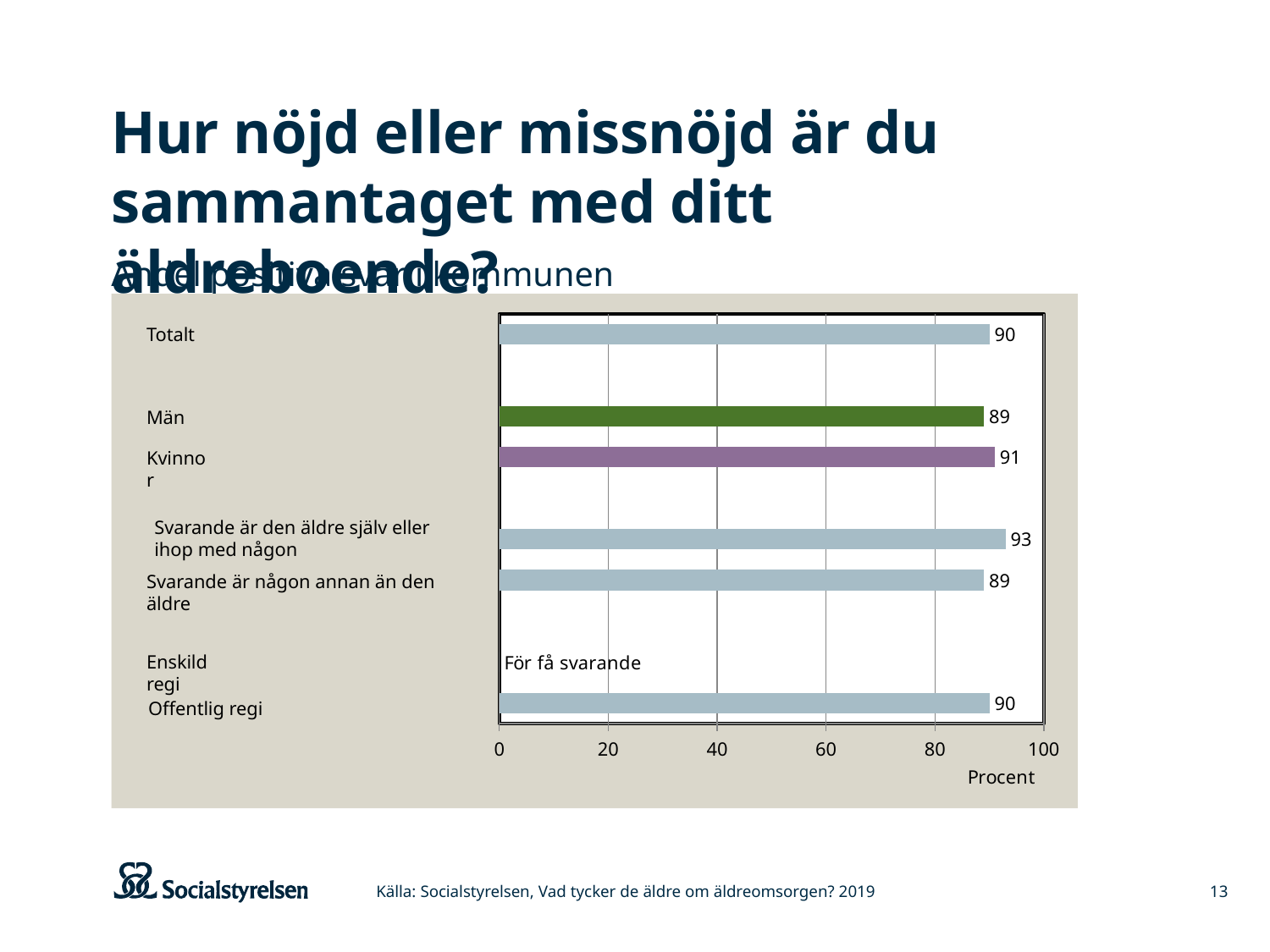
What is shown instead of a bar for Enskild regi? För få svarande Which is larger, the value for Kvinnor or the value for Män? Kvinnor Which category has the highest value? Svarande är den äldre själv eller ihop med någon What is the value for Totalt? 90 What is the value for Kvinnor? 91 What is the label of the x axis? Procent What is the value for 'Svarande är den äldre själv eller ihop med någon'? 93 What kind of chart is shown on the slide? Bar chart What is the difference between the values for Kvinnor and Män? 2 What is the value for Offentlig regi? 90 What is the value for Män? 89 What is the difference between 'Svarande är den äldre själv eller ihop med någon' and 'Svarande är någon annan än den äldre'? 4